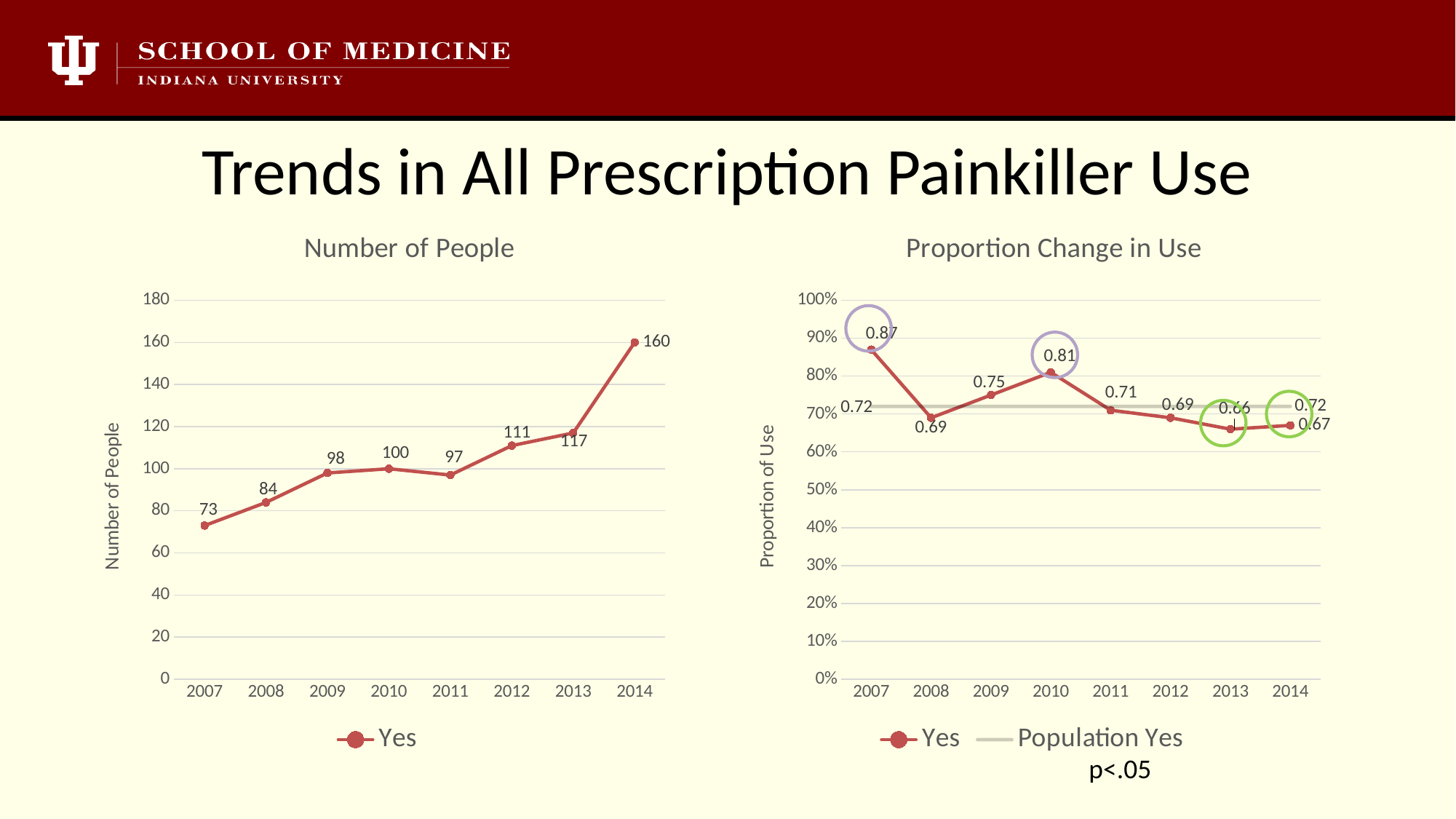
In the 'Number of People' chart, which year has the highest value? 2014 In the 'Proportion Change in Use' chart, which year has the lowest 'Yes' value? 2013 In the 'Number of People' chart, what is the value for 2007? 73 In the 'Number of People' chart, how many years are plotted on the x axis? 8 In the 'Proportion Change in Use' chart, how many series does the legend list? 2 What kind of chart is the 'Number of People' chart? Line chart In the 'Proportion Change in Use' chart, which year has the highest 'Yes' value? 2007 In the 'Number of People' chart, what is the value for 2014? 160 In the 'Number of People' chart, which year has the lowest value? 2007 In the 'Number of People' chart, what is the difference between the values for 2014 and 2013? 43 In the 'Proportion Change in Use' chart, what is the 'Yes' value for 2010? 0.81 In the 'Proportion Change in Use' chart, is the 'Yes' value for 2008 larger or smaller than the 'Yes' value for 2009? Smaller